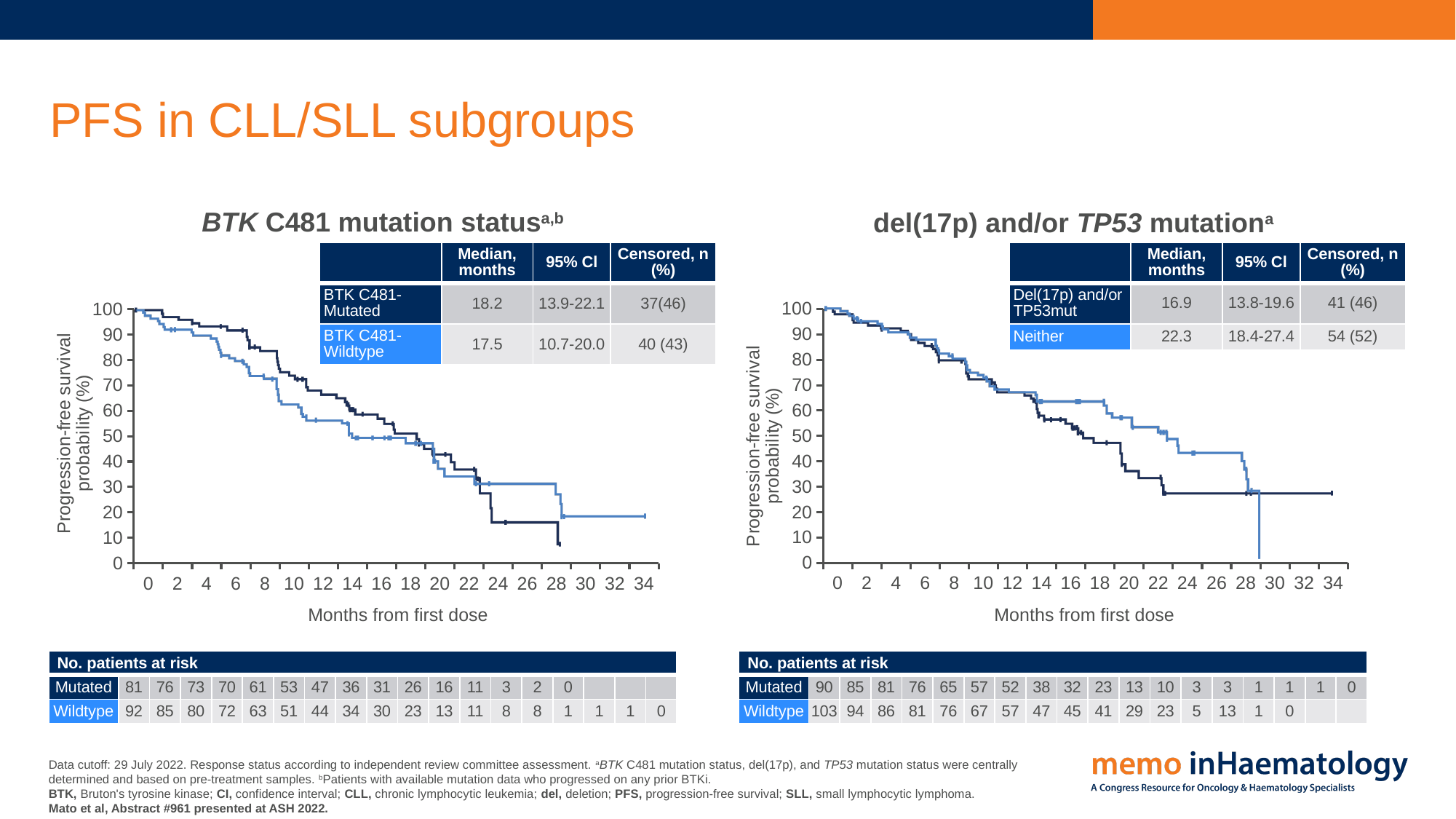
In the del(17p) and/or TP53 mutation chart, how many Mutated patients were at risk at month 0? 90 What kind of chart is used on this slide to show progression-free survival? Line chart (Kaplan-Meier survival curve) In the BTK C481 mutation status chart, what is the median PFS in months for the BTK C481-Mutated group? 18.2 In the del(17p) and/or TP53 mutation chart, which group has the higher median PFS? Neither In the del(17p) and/or TP53 mutation chart, is the PFS probability for the Neither group at month 10 greater or less than 50? greater In the del(17p) and/or TP53 mutation chart, what is the median PFS in months for the Neither group? 22.3 In the del(17p) and/or TP53 mutation chart, what is the censored n (%) for the Del(17p) and/or TP53mut group? 41 (46) In the del(17p) and/or TP53 mutation chart, what is the difference in median PFS months between the Neither and Del(17p) and/or TP53mut groups? 5.4 In the BTK C481 mutation status chart, what is the 95% CI for the BTK C481-Wildtype group? 10.7-20.0 In the BTK C481 mutation status chart, what is the difference in median PFS months between the Mutated and Wildtype groups? 0.7 In the BTK C481 mutation status chart, how many Wildtype patients were at risk at month 0? 92 In the BTK C481 mutation status chart, does progression-free survival probability rise or fall as months from first dose increase? Fall